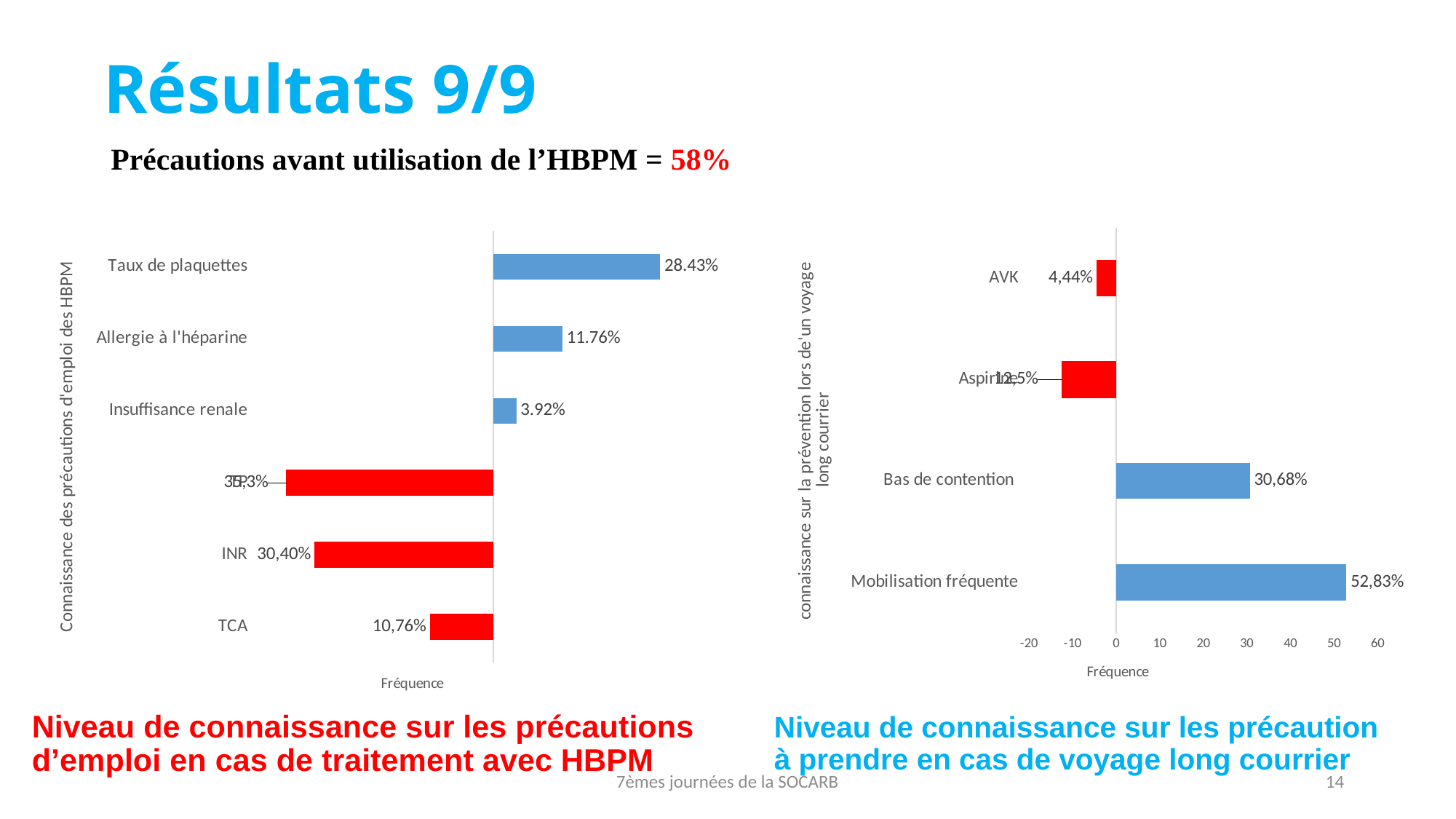
In the right chart, what is the difference between the values for Mobilisation fréquente and Bas de contention? 22,15% In the left chart, what is the value for TCA? 10,76% In the left chart, what is the value for INR? 30,40% In the right chart (connaissance sur la prévention lors de'un voyage long courrier), what is the value for AVK? 4,44% In the right chart, which category has the highest value? Mobilisation fréquente In the left chart (Connaissance des précautions d'emploi des HBPM), what is the value for Taux de plaquettes? 28.43% In the left chart, what is the value for Allergie à l'héparine? 11.76% What kind of chart is the left chart? Bar chart How many categories are shown in the right chart? 4 In the right chart, what is the value for Bas de contention? 30,68% In the right chart, what is the value for Mobilisation fréquente? 52,83% In the left chart, what is the value for Insuffisance renale? 3.92%